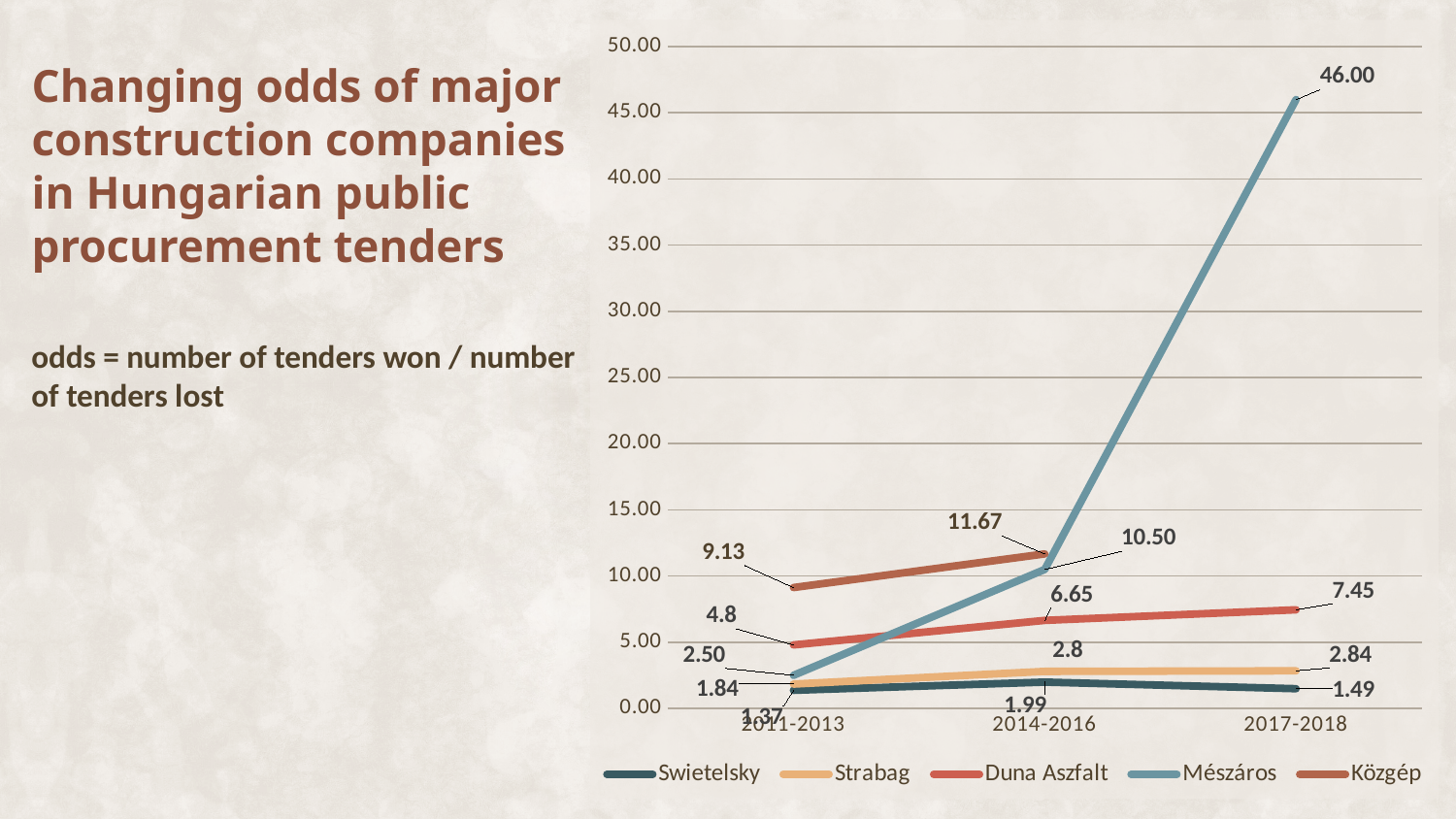
How many time periods are shown on the x axis? 3 What are the odds for Duna Aszfalt in 2017-2018? 7.45 Do the odds for Duna Aszfalt rise or fall across the three periods? rise Which company has the lowest odds in 2011-2013? Swietelsky What are the odds for Közgép in 2011-2013? 9.13 How many series does the legend list? 5 What kind of chart is shown on the slide? line chart Which company has the highest odds in 2017-2018? Mészáros In 2014-2016, which has higher odds: Közgép or Mészáros? Közgép By how much did the odds for Mészáros increase from 2014-2016 to 2017-2018? 35.50 What are the odds for Mészáros in 2017-2018? 46.00 What are the odds for Strabag in 2014-2016? 2.8